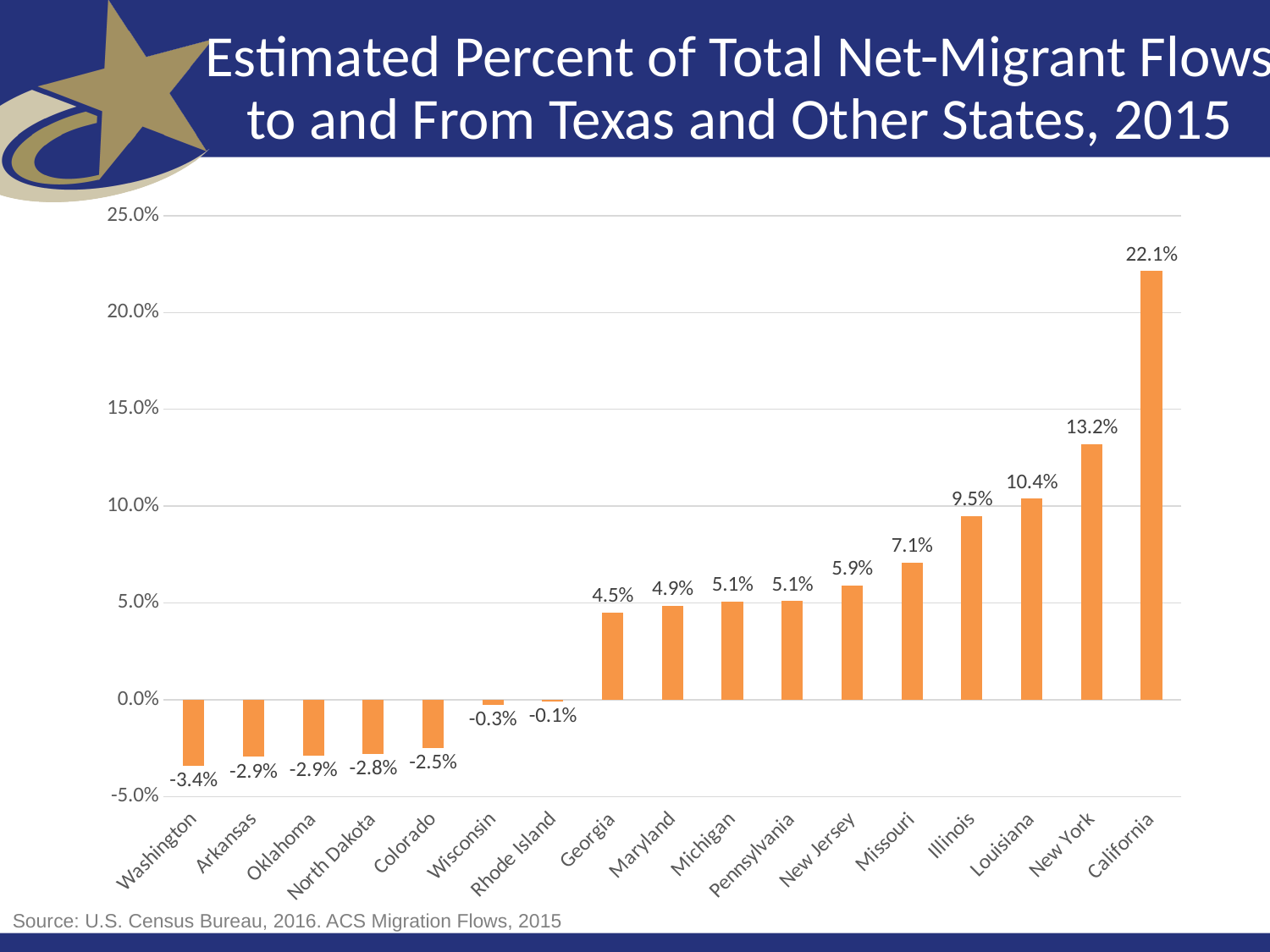
Which state has the highest value? California What kind of chart is shown on the slide? bar chart Which state has the lowest value? Washington What is the value for Missouri? 7.1% Do the values rise or fall moving from left to right along the x axis? rise What is the difference between the values for California and New York? 8.9% Is the value for New York greater or less than 10.0%? greater How many states are shown on the x axis? 17 What is the value for California? 22.1% What is the value for Washington? -3.4% Which is larger, the value for New Jersey or the value for Georgia? New Jersey What is the difference between the values for Louisiana and Illinois? 0.9%